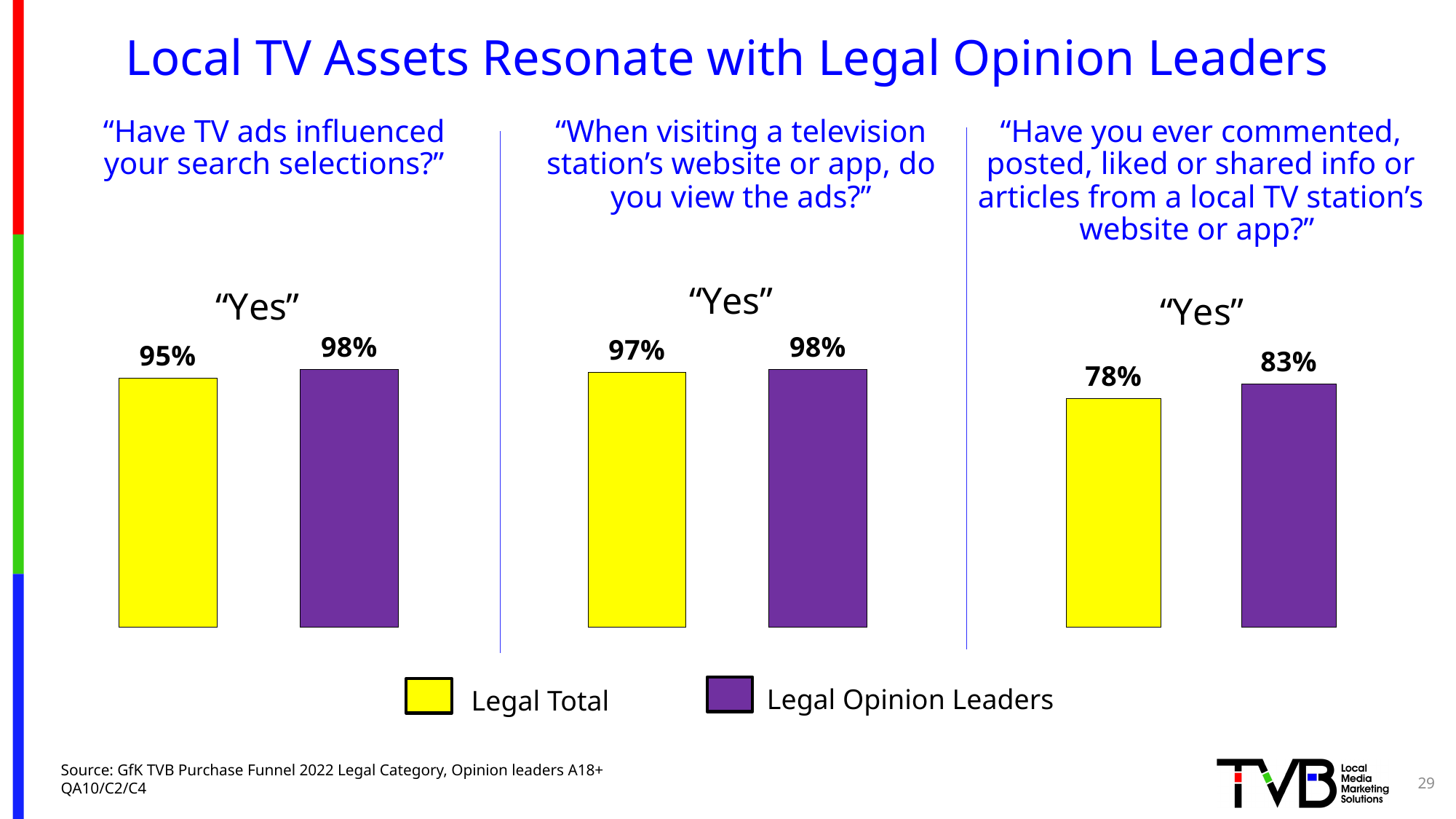
In the left chart ("Have TV ads influenced your search selections?"), what is the difference between Legal Opinion Leaders and Legal Total? 3% In the right chart ("Have you ever commented, posted, liked or shared info..."), which group has the lower value? Legal Total How many bars are shown in the middle chart ("When visiting a television station's website or app, do you view the ads?")? 2 In the middle chart ("When visiting a television station's website or app, do you view the ads?"), which group has the higher value, Legal Total or Legal Opinion Leaders? Legal Opinion Leaders In the left chart ("Have TV ads influenced your search selections?"), what percentage of Legal Total answered "Yes"? 95% In the middle chart ("When visiting a television station's website or app, do you view the ads?"), what is the value for Legal Total? 97% What type of chart is used on this slide? Bar chart Which colour represents Legal Opinion Leaders in the legend? Purple In the right chart ("Have you ever commented, posted, liked or shared info or articles from a local TV station's website or app?"), what is the value for Legal Opinion Leaders? 83% In the left chart ("Have TV ads influenced your search selections?"), what percentage of Legal Opinion Leaders answered "Yes"? 98% How many series does the legend list? 2 In the right chart ("Have you ever commented, posted, liked or shared info..."), what is the difference between Legal Opinion Leaders and Legal Total? 5%